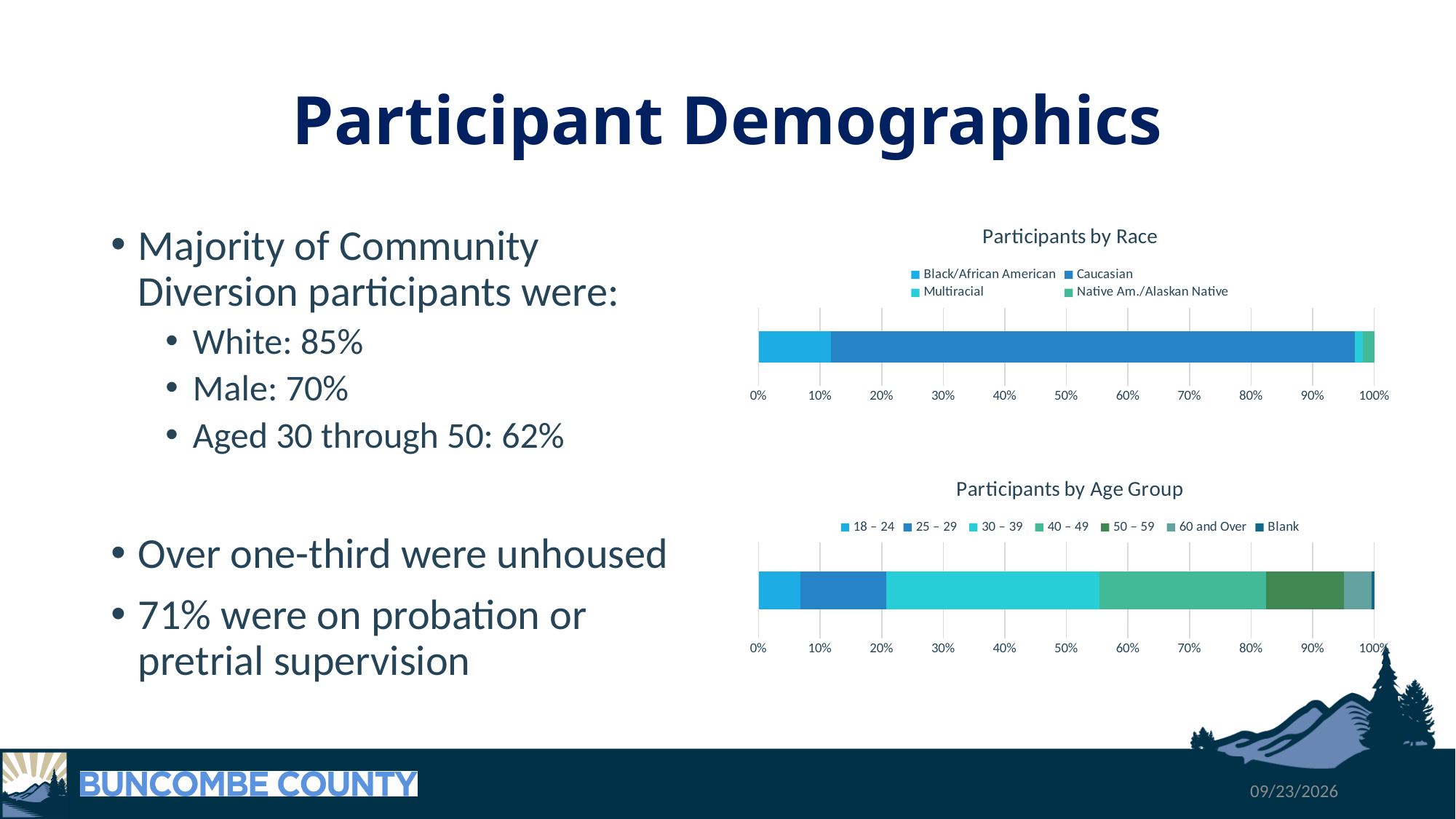
In the 'Participants by Age Group' chart, which age group makes up the largest segment of the bar? 30 – 39 How many series does the legend of the 'Participants by Age Group' chart list? 7 In the 'Participants by Age Group' chart, which segment is larger: 30 – 39 or 40 – 49? 30 – 39 In the 'Participants by Race' chart, is the share for Black/African American greater or less than 20%? less How many series does the legend of the 'Participants by Race' chart list? 4 In the 'Participants by Race' chart, is the share for Caucasian greater or less than 50%? greater In the 'Participants by Age Group' chart, which age group makes up the smallest segment of the bar? Blank In the 'Participants by Race' chart, which race group makes up the largest segment of the bar? Caucasian In the 'Participants by Age Group' chart, is the share for 18 – 24 greater or less than 10%? less What is the title of the lower chart on the slide? Participants by Age Group What kind of chart is the 'Participants by Race' chart? bar chart